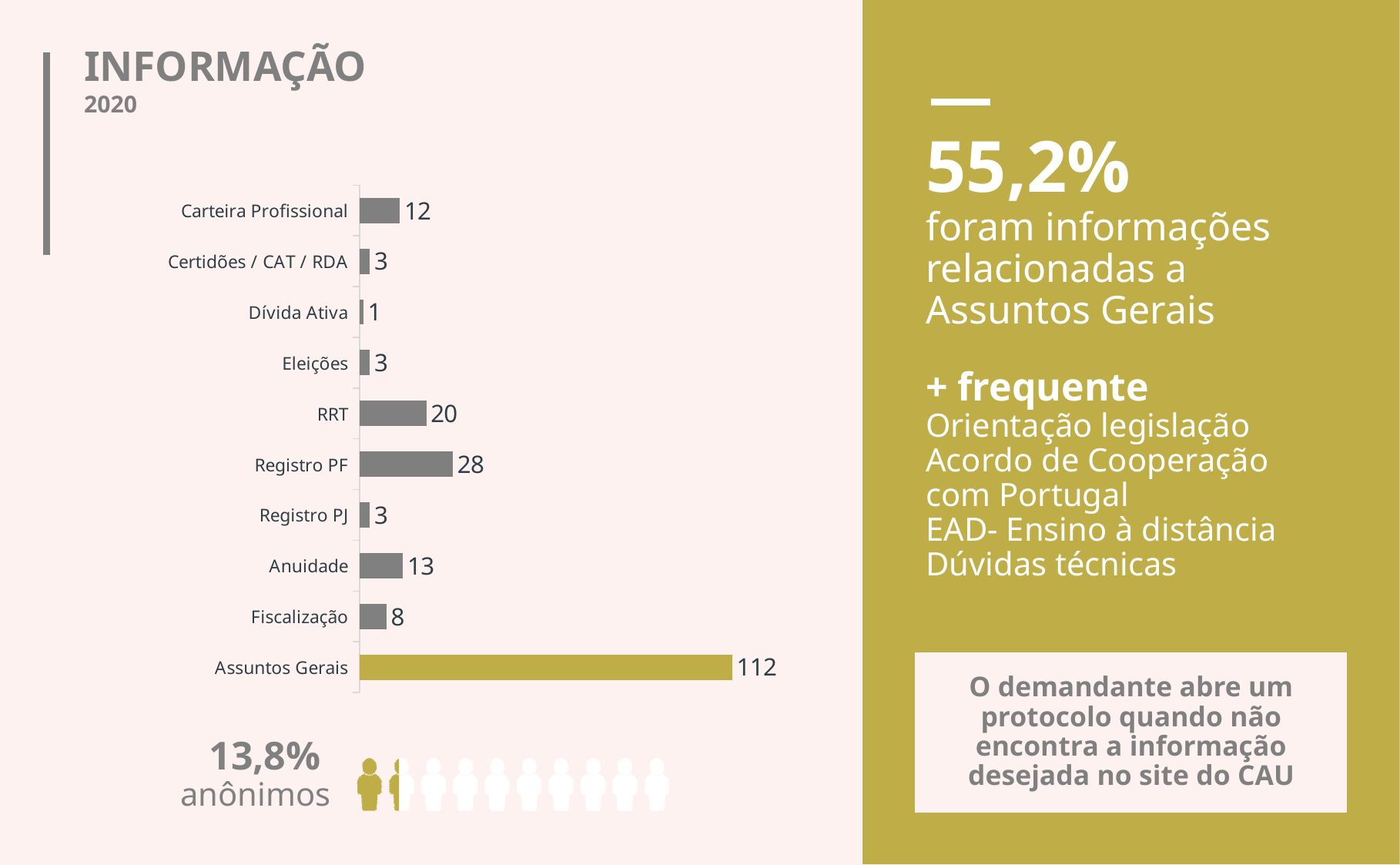
Which category has the highest value? Assuntos Gerais Which bar in the chart is coloured differently (gold) from the others? Assuntos Gerais What is the value for Anuidade? 13 Which is larger, the value for Carteira Profissional or the value for Anuidade? Anuidade What is the difference between the values for Assuntos Gerais and Registro PF? 84 What is the value for Assuntos Gerais? 112 How many categories are shown in the bar chart? 10 Which category has the lowest value? Dívida Ativa What is the value for RRT? 20 What is the value for Fiscalização? 8 What is the value for Registro PF? 28 What kind of chart is shown on the slide? Bar chart